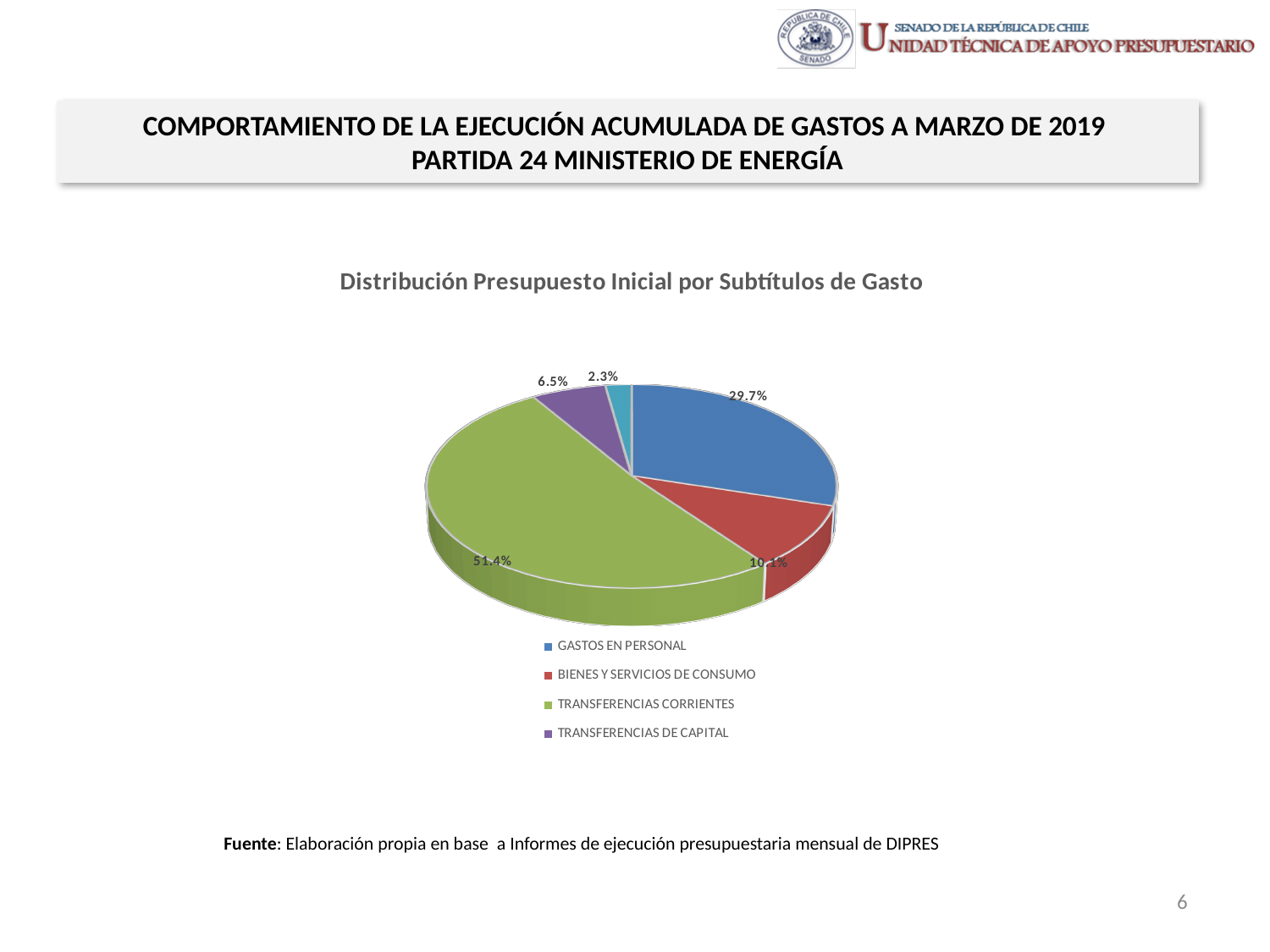
Which is larger, the slice for GASTOS EN PERSONAL or the slice for BIENES Y SERVICIOS DE CONSUMO? GASTOS EN PERSONAL Which category has the largest slice of the pie? TRANSFERENCIAS CORRIENTES What is the difference in percentage points between TRANSFERENCIAS CORRIENTES and GASTOS EN PERSONAL? 21.7 How many slices does the pie chart have? 5 What share of the pie does TRANSFERENCIAS CORRIENTES represent? 51.4% What is the title of the chart? Distribución Presupuesto Inicial por Subtítulos de Gasto What share of the pie does BIENES Y SERVICIOS DE CONSUMO represent? 10.1% What share of the pie does GASTOS EN PERSONAL represent? 29.7% What kind of chart is shown on the slide? pie chart How many entries does the legend list? 4 Which of the legend categories has the smallest slice of the pie? TRANSFERENCIAS DE CAPITAL